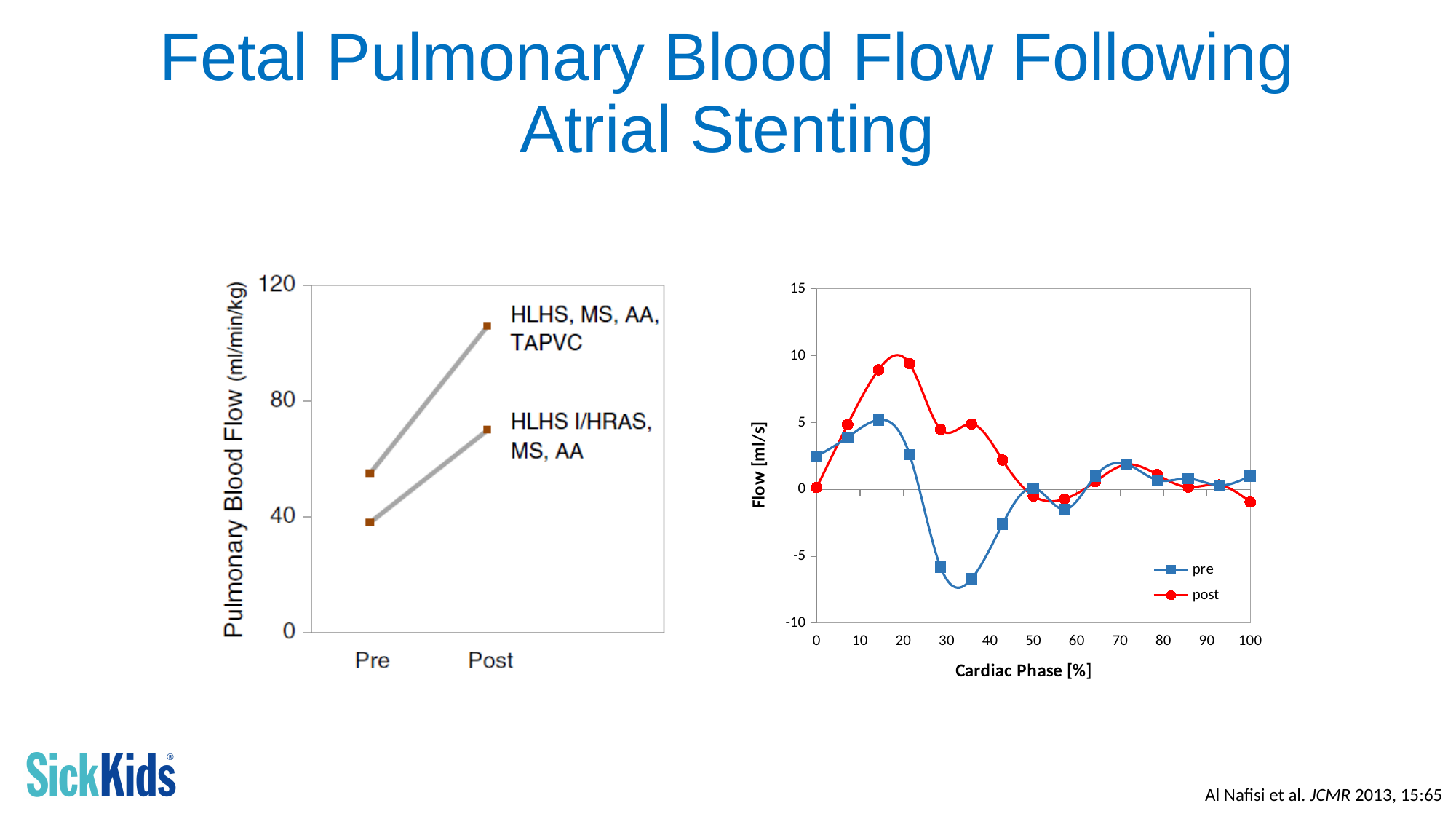
In the right chart (Flow vs Cardiac Phase), which series reaches the higher peak flow? post In the left chart (Pulmonary Blood Flow), is the Pre value for HLHS, MS, AA, TAPVC greater or less than 40? greater How many series does the legend of the right chart (Flow vs Cardiac Phase) list? 2 In the left chart (Pulmonary Blood Flow), is the Post value for HLHS, MS, AA, TAPVC greater or less than 80? greater What kind of chart is the left chart (Pulmonary Blood Flow, Pre vs Post)? line chart In the left chart (Pulmonary Blood Flow), do the values rise or fall from Pre to Post? rise What is the y-axis label of the left chart? Pulmonary Blood Flow (ml/min/kg) In the left chart (Pulmonary Blood Flow), which group has the higher Post value? HLHS, MS, AA, TAPVC In the left chart (Pulmonary Blood Flow), is the Post value for HLHS I/HRAS, MS, AA greater or less than 80? less What are the legend entries of the right chart (Flow vs Cardiac Phase)? pre, post